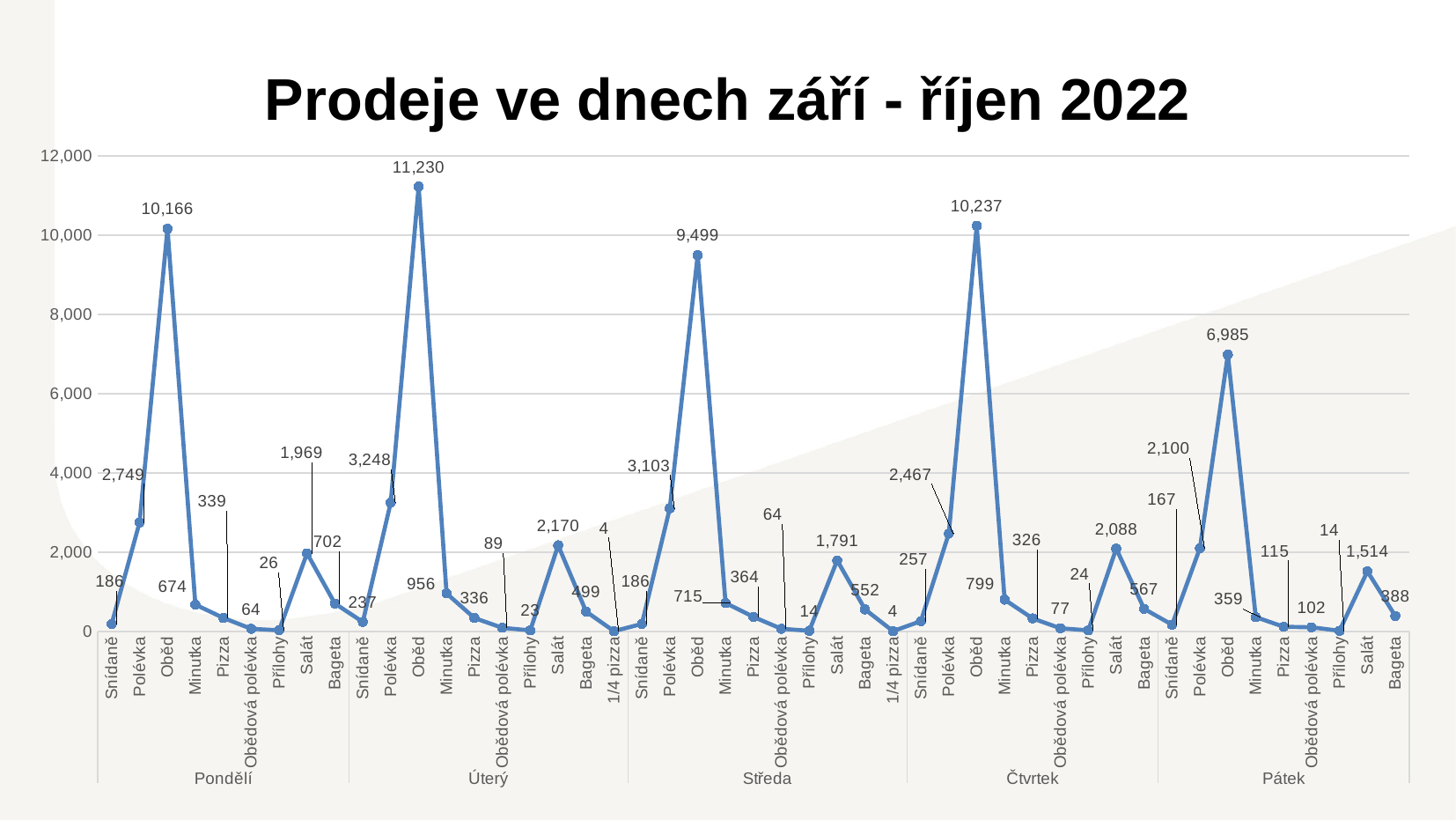
Which is larger, Polévka on Úterý or Polévka on Středa? Polévka on Úterý Which day has the lowest value for Oběd? Pátek What is the value for Oběd on Úterý? 11,230 How many day groups are shown along the x axis? 5 What is the value for Polévka on Čtvrtek? 2,467 Is the value for Oběd on Středa greater or less than 8,000? greater What is the value for Salát on Pondělí? 1,969 Which day has the highest value for Oběd? Úterý What type of chart is shown on the slide? line chart What is the difference between Salát on Čtvrtek and Salát on Pátek? 574 What is the title of the chart? Prodeje ve dnech září - říjen 2022 What is the difference between Oběd on Úterý and Oběd on Pátek? 4,245